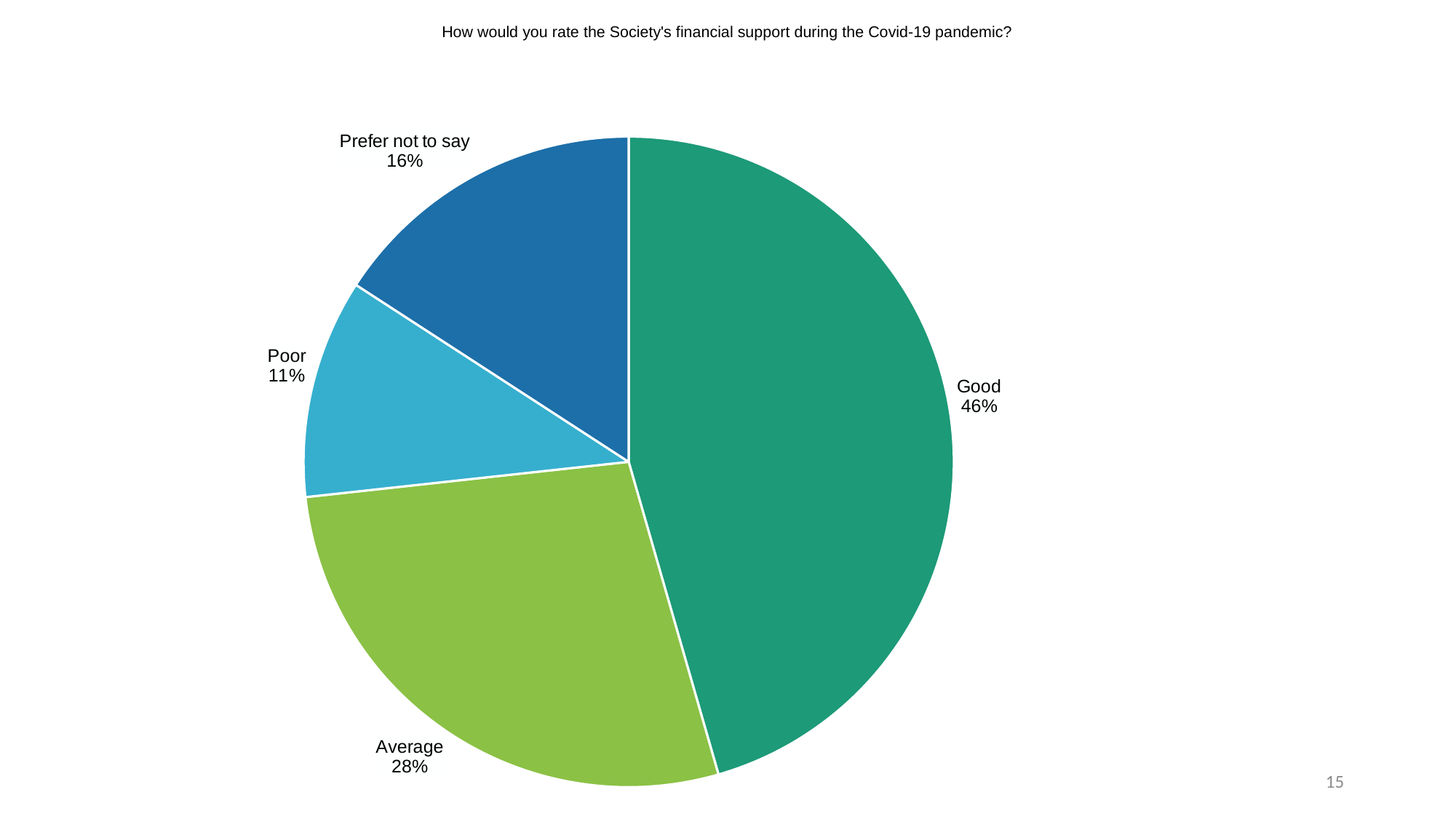
What percentage of respondents rated the Society's financial support as Average? 28% Which rating category has the largest share of the pie? Good Which rating category has the smallest share of the pie? Poor What kind of chart is shown on the slide? pie chart What percentage of respondents rated the Society's financial support as Poor? 11% What percentage of respondents rated the Society's financial support as Good? 46% What percentage of respondents chose 'Prefer not to say'? 16% How many slices does the pie chart have? 4 What is the title of the chart? How would you rate the Society's financial support during the Covid-19 pandemic? Which is larger, the share for 'Prefer not to say' or the share for Poor? Prefer not to say What is the difference in percentage points between the Good and Average slices? 18 What is the difference in percentage points between the 'Prefer not to say' and Poor slices? 5